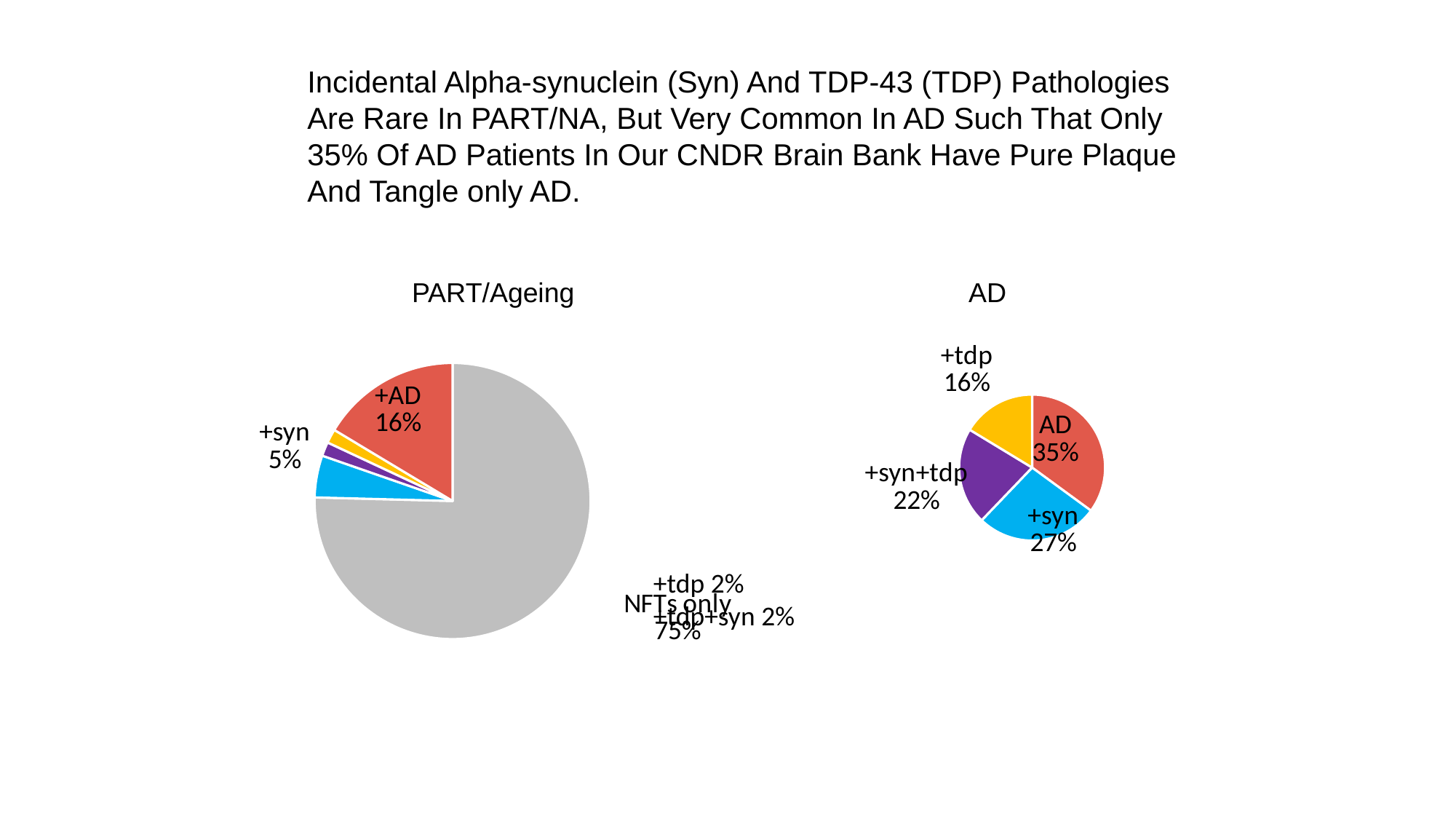
In the AD chart, what share is labelled for AD? 35% In the PART/Ageing chart, what share is labelled for +syn? 5% In the AD chart, what share is labelled for +syn+tdp? 22% How many slices does the AD pie chart have? 4 In the AD chart, what is the difference between the AD share and the +syn share? 8% What kind of chart is the PART/Ageing chart? pie chart In the PART/Ageing chart, what share is labelled for +AD? 16% In the AD chart, what share is labelled for +tdp? 16% In the AD chart, which is larger, +syn or +syn+tdp? +syn In the AD chart, which slice is the smallest? +tdp In the PART/Ageing chart, which slice is the largest? NFTs only In the PART/Ageing chart, what share is labelled for NFTs only? 75%